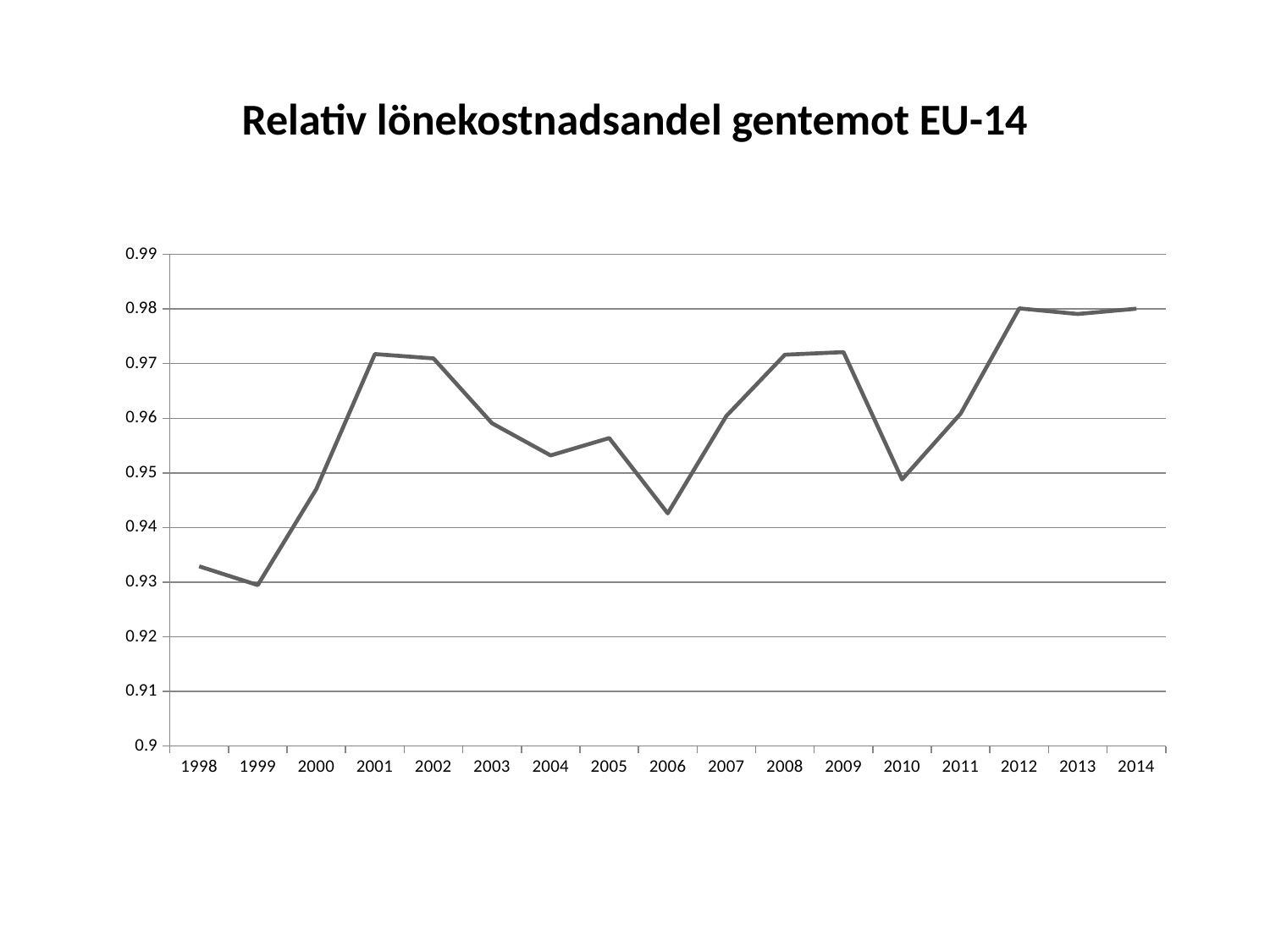
What kind of chart is shown on the slide? line chart Which year has the lowest value on the chart? 1999 Is the value for 2011 greater or less than 0.95? greater Which year has the larger value, 2001 or 2006? 2001 Does the value rise or fall from 1999 to 2001? rise Is the value for 2006 greater or less than 0.95? less Is the value for 2012 greater or less than 0.97? greater Which year has the larger value, 2010 or 2012? 2012 What is the title of the chart? Relativ lönekostnadsandel gentemot EU-14 How many years are plotted along the x axis? 17